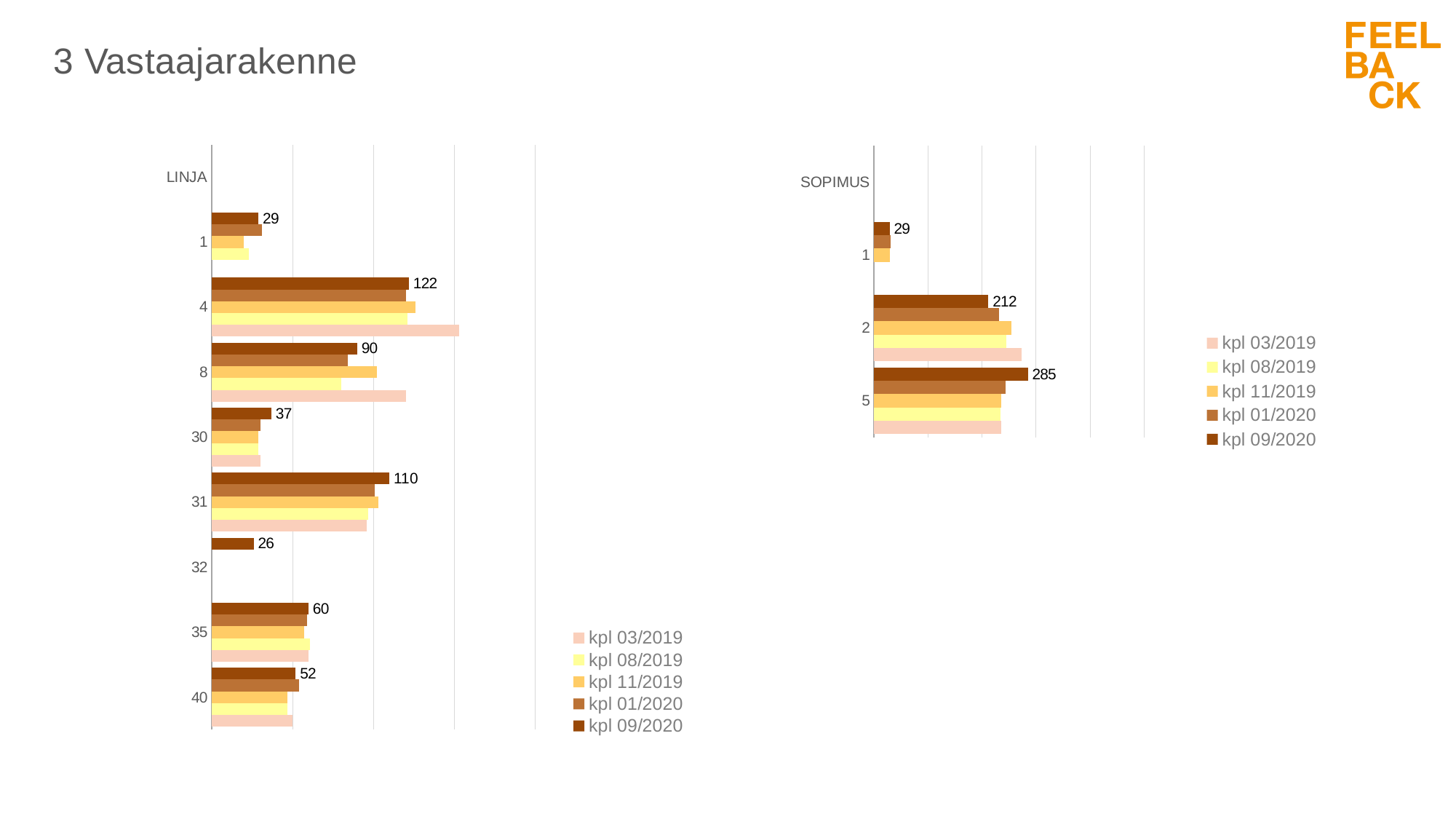
How many series does the legend of the SOPIMUS chart list? 5 How many categories are shown in the LINJA chart? 8 In the LINJA chart, what is the kpl 09/2020 value for category 32? 26 In the SOPIMUS chart, what is the kpl 09/2020 value for category 5? 285 In the LINJA chart, which category has the highest kpl 09/2020 value? 4 In the SOPIMUS chart, what is the difference between the kpl 09/2020 values for categories 5 and 2? 73 In the LINJA chart, which has the larger kpl 09/2020 value, category 8 or category 35? 8 In the LINJA chart, what is the kpl 09/2020 value for category 4? 122 In the LINJA chart, what is the difference between the kpl 09/2020 values for categories 4 and 31? 12 In the SOPIMUS chart, which category has the highest kpl 09/2020 value? 5 What kind of chart is the LINJA chart? bar chart In the LINJA chart, which category has the lowest kpl 09/2020 value? 32